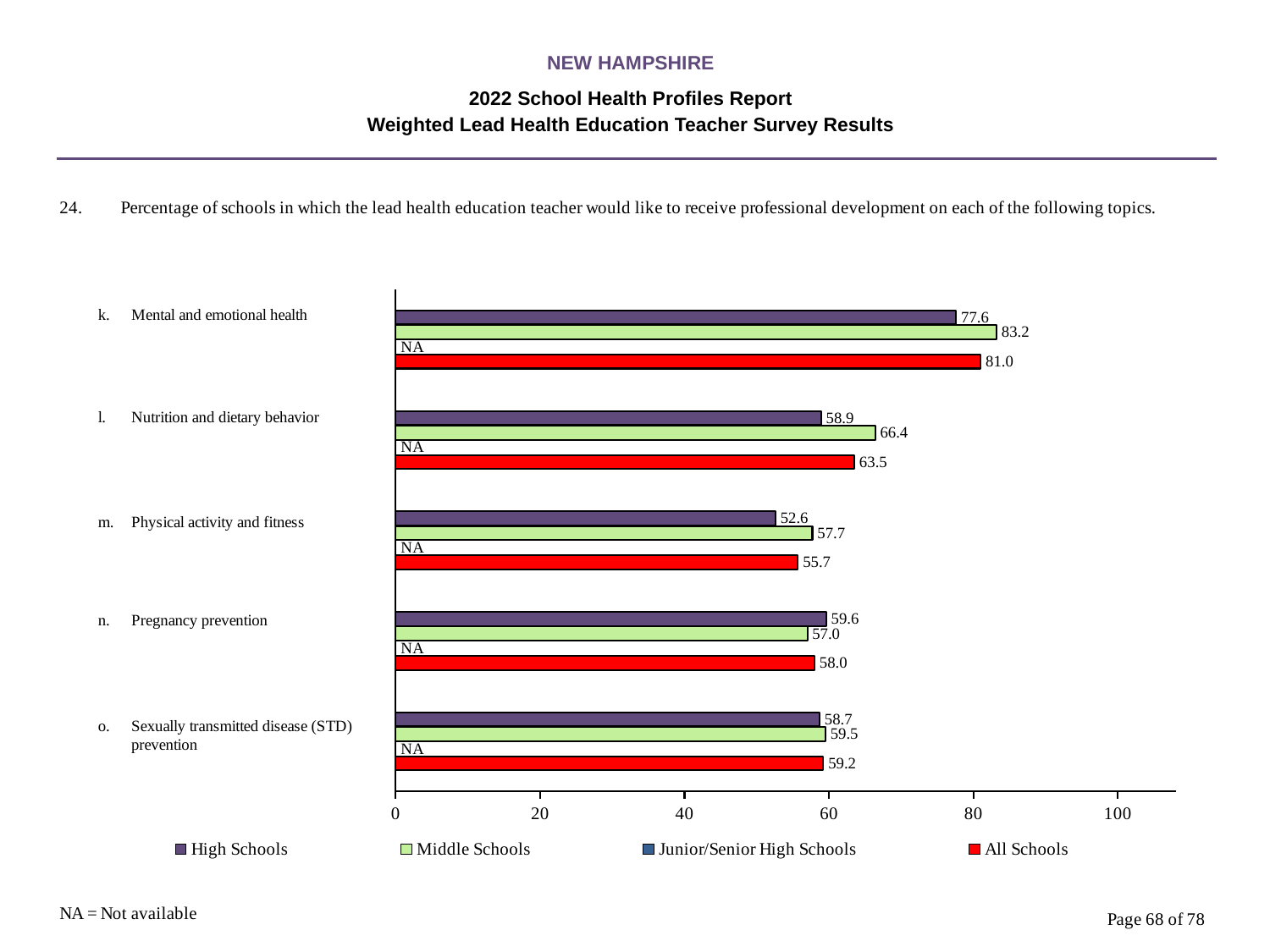
What is the value for High Schools for Physical activity and fitness? 52.6 What is the value for Middle Schools for Pregnancy prevention? 57.0 Which topic has the highest value for All Schools? Mental and emotional health Which is larger for Pregnancy prevention: the High Schools value or the Middle Schools value? High Schools How many topics are shown in the chart? 5 How many series does the legend list? 4 Which topic has the lowest value for High Schools? Physical activity and fitness What is the value for Middle Schools for Mental and emotional health? 83.2 What kind of chart is shown on the slide? Bar chart What value is shown for Junior/Senior High Schools for each topic? NA What is the value for All Schools for Nutrition and dietary behavior? 63.5 What is the difference between the Middle Schools and High Schools values for Nutrition and dietary behavior? 7.5